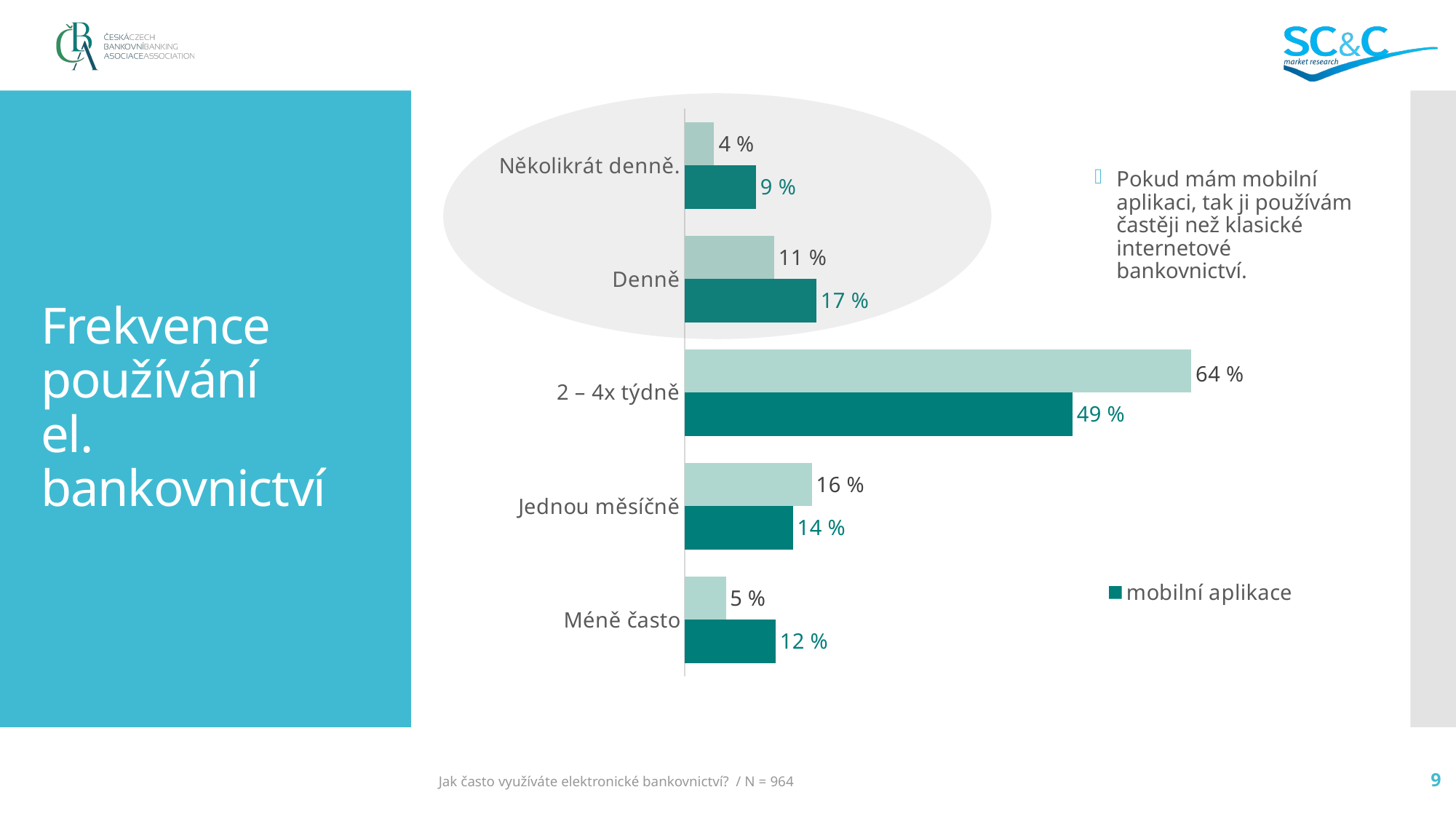
In the "Jednou měsíčně" category, which is larger: the "mobilní aplikace" bar or the lighter bar? the lighter bar In the "2 – 4x týdně" category, what is the difference between the lighter bar (64 %) and the "mobilní aplikace" bar (49 %)? 15 percentage points What kind of chart is shown on the slide? bar chart What is the value for "mobilní aplikace" in the "Denně" category? 17 % How many series does the legend list? 1 Which category has the highest value for "mobilní aplikace"? 2 – 4x týdně What is the value for "mobilní aplikace" in the "Méně často" category? 12 % What is the value for "mobilní aplikace" in the "2 – 4x týdně" category? 49 % How many categories are shown on the chart? 5 What value is shown on the lighter bar for "2 – 4x týdně"? 64 % In the "Méně často" category, which is larger: the "mobilní aplikace" bar or the lighter bar? mobilní aplikace Which category has the lowest value for "mobilní aplikace"? Několikrát denně.